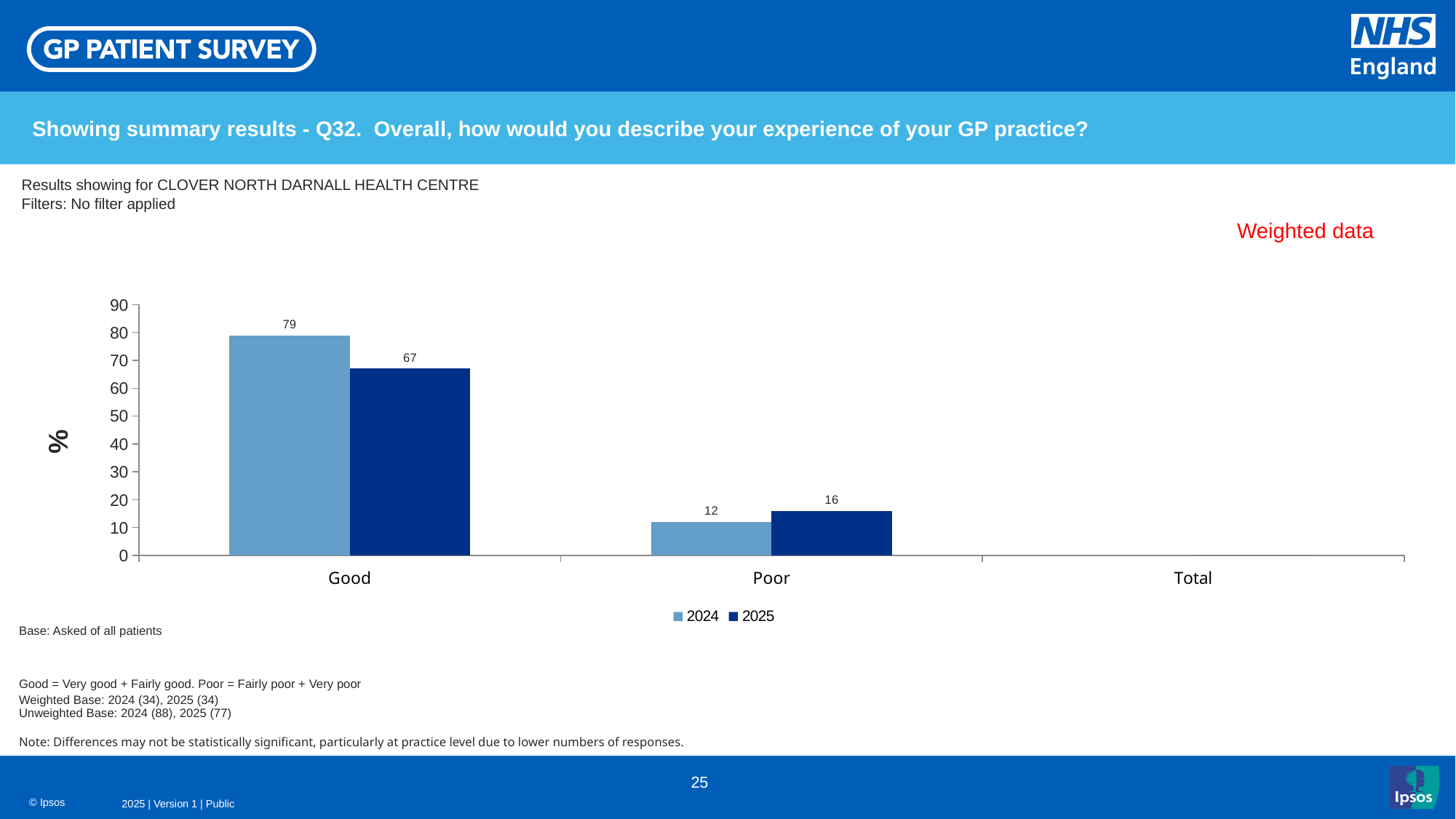
What is the value for Poor in 2025? 16 What is the difference between the 2024 and 2025 values for Good? 12 What kind of chart is shown on the slide? Bar chart What is the difference between the 2025 and 2024 values for Poor? 4 What is the label on the vertical axis of the chart? % What is the value for Poor in 2024? 12 Which category has the lowest value for the 2024 series? Poor What is the value for Good in 2024? 79 Which is larger for Poor: the 2024 value or the 2025 value? 2025 How many series does the legend list? 2 Which category has the highest value for the 2025 series? Good What is the value for Good in 2025? 67